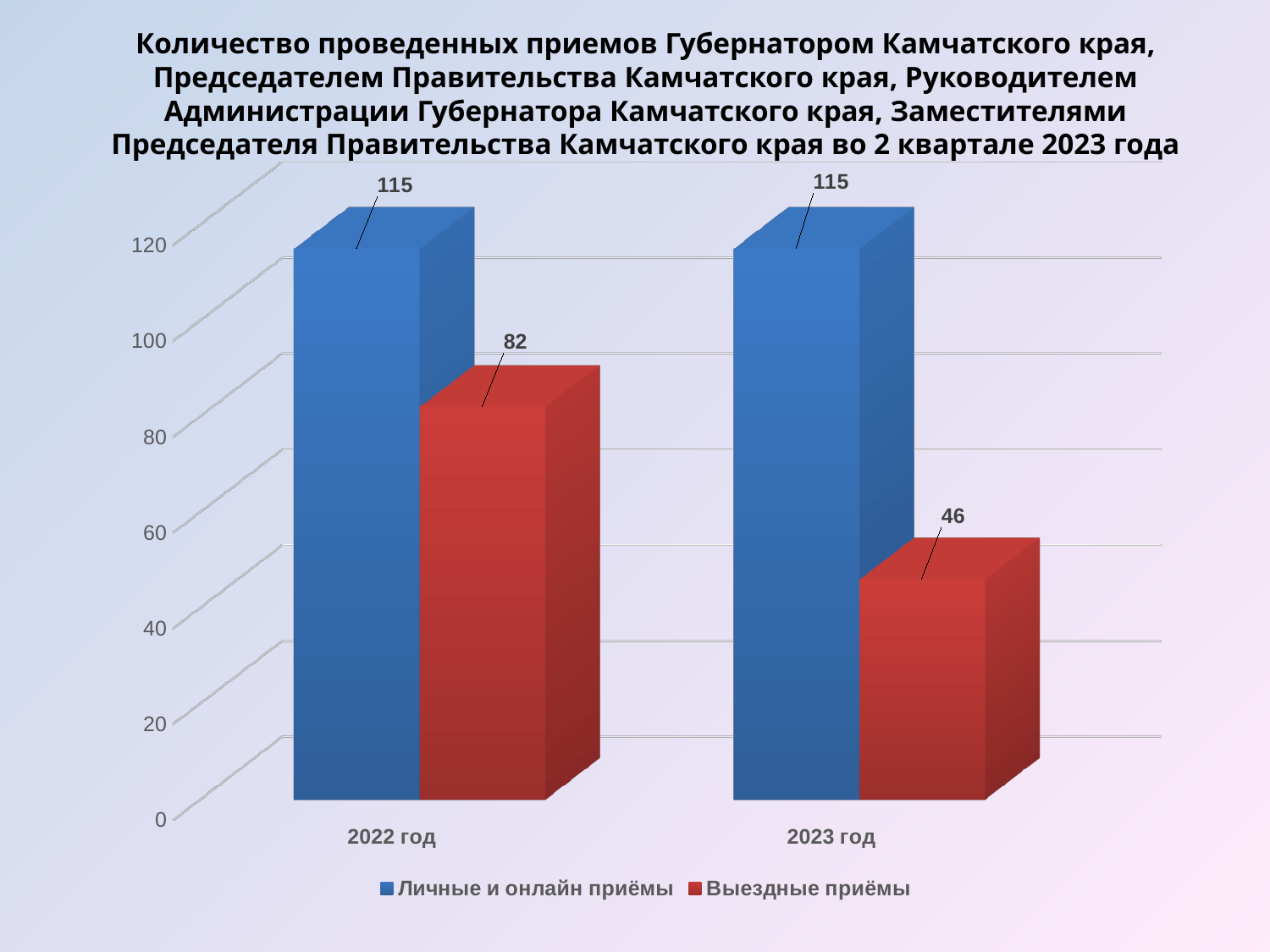
What kind of chart is shown on the slide? Bar chart Do the values for Выездные приёмы rise or fall from 2022 год to 2023 год? Fall What is the value for Выездные приёмы in 2022 год? 82 Which is larger in 2022 год: Личные и онлайн приёмы or Выездные приёмы? Личные и онлайн приёмы How many series does the legend list? 2 What is the value for Личные и онлайн приёмы in 2023 год? 115 Which year has the lowest value for Выездные приёмы? 2023 год What is the value for Личные и онлайн приёмы in 2022 год? 115 How many categories are shown on the x axis? 2 What is the value for Выездные приёмы in 2023 год? 46 What is the difference between Личные и онлайн приёмы and Выездные приёмы in 2023 год? 69 What is the difference between Выездные приёмы in 2022 год and 2023 год? 36